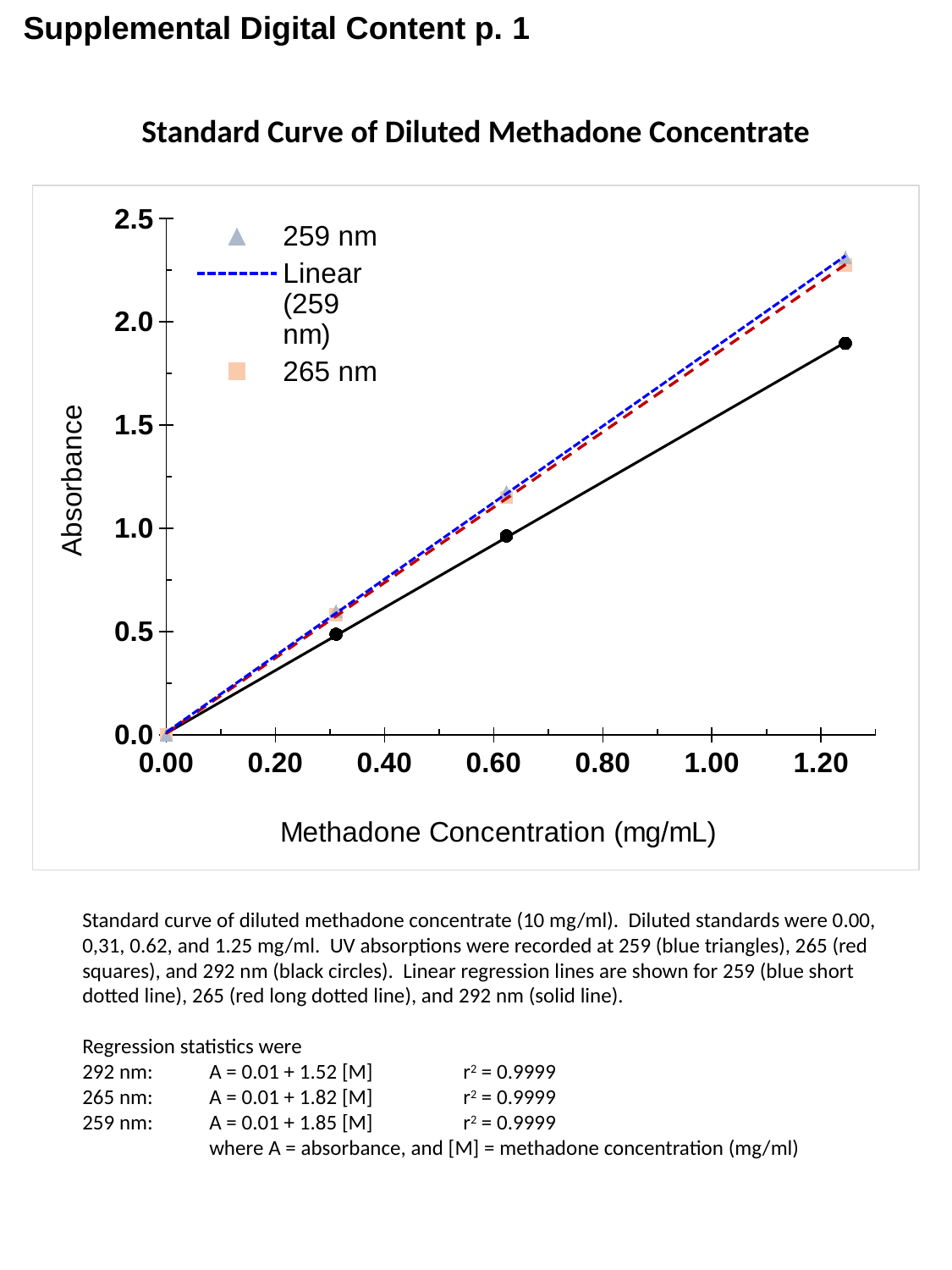
Which series has the lowest absorbance at 1.25 mg/mL? 292 nm Is the absorbance of the 292 nm (black circle) series at 1.25 mg/mL greater or less than 2.0? less How many entries does the chart legend list? 3 Does absorbance rise or fall as methadone concentration increases along the x axis? Rises At 1.25 mg/mL, which series has the higher absorbance: 259 nm or 292 nm? 259 nm What is the title of the chart? Standard Curve of Diluted Methadone Concentrate What is the label of the x axis of the chart? Methadone Concentration (mg/mL) What kind of chart is shown on the slide? Scatter chart with linear trend lines Is the absorbance of the 259 nm (blue triangle) series at 1.25 mg/mL greater or less than 2.0? greater How many data points are plotted for the 292 nm (black circles) series? 4 Is the absorbance of the 259 nm (blue triangle) series at about 0.62 mg/mL greater or less than 1.0? greater